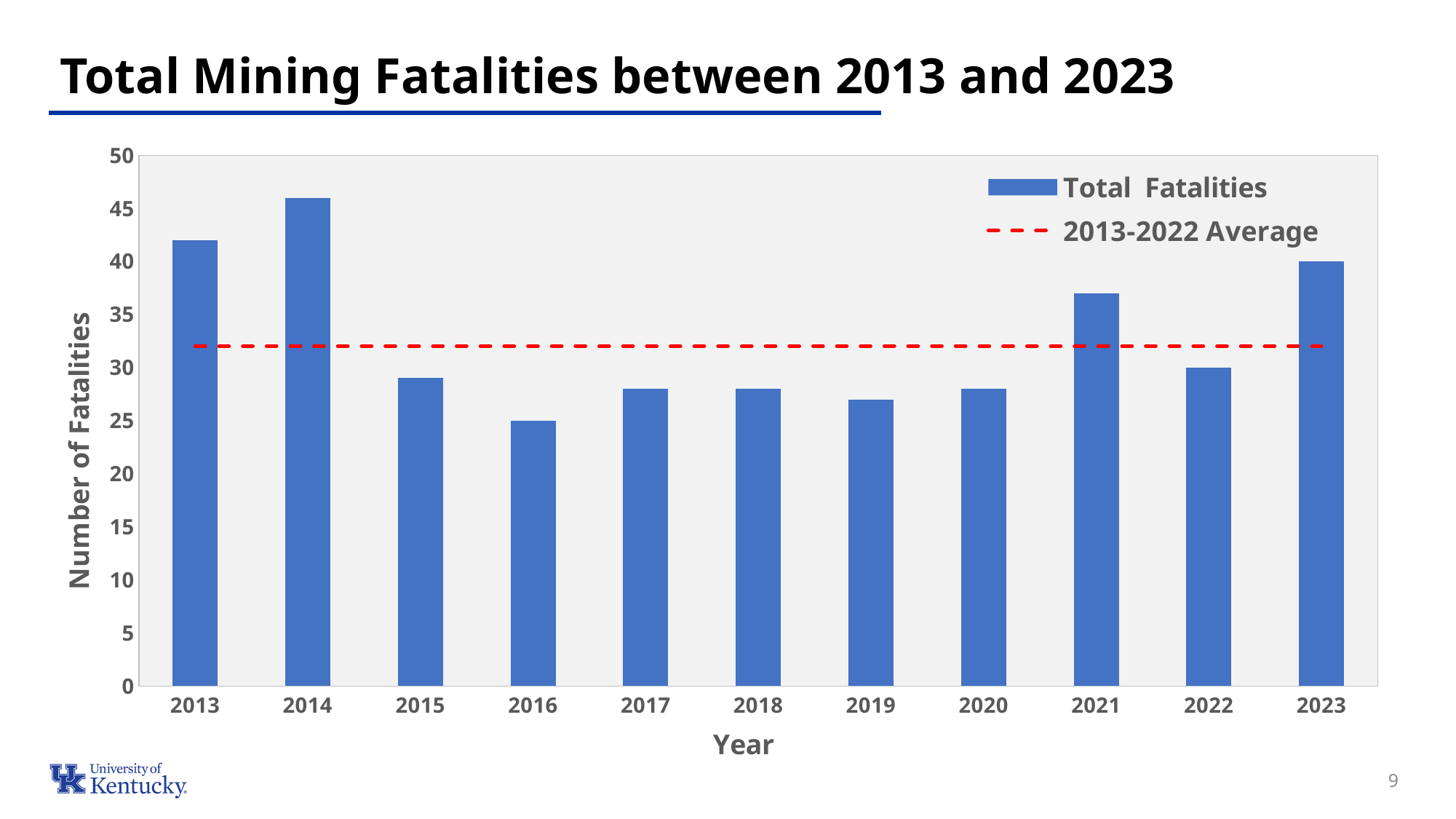
What does the red dashed line represent according to the legend? 2013-2022 Average Do the values rise or fall from 2013 to 2016? fall What kind of chart is shown on the slide? bar chart Which year has the lowest number of total fatalities? 2016 Which year has the highest number of total fatalities? 2014 Is the value for 2013 greater or less than 40? greater Which year has more fatalities, 2014 or 2021? 2014 How many years are shown on the x axis? 11 What is the number of fatalities for 2016? 25 Is the value for 2015 greater or less than 30? less What is the number of fatalities for 2023? 40 How many entries does the legend list? 2